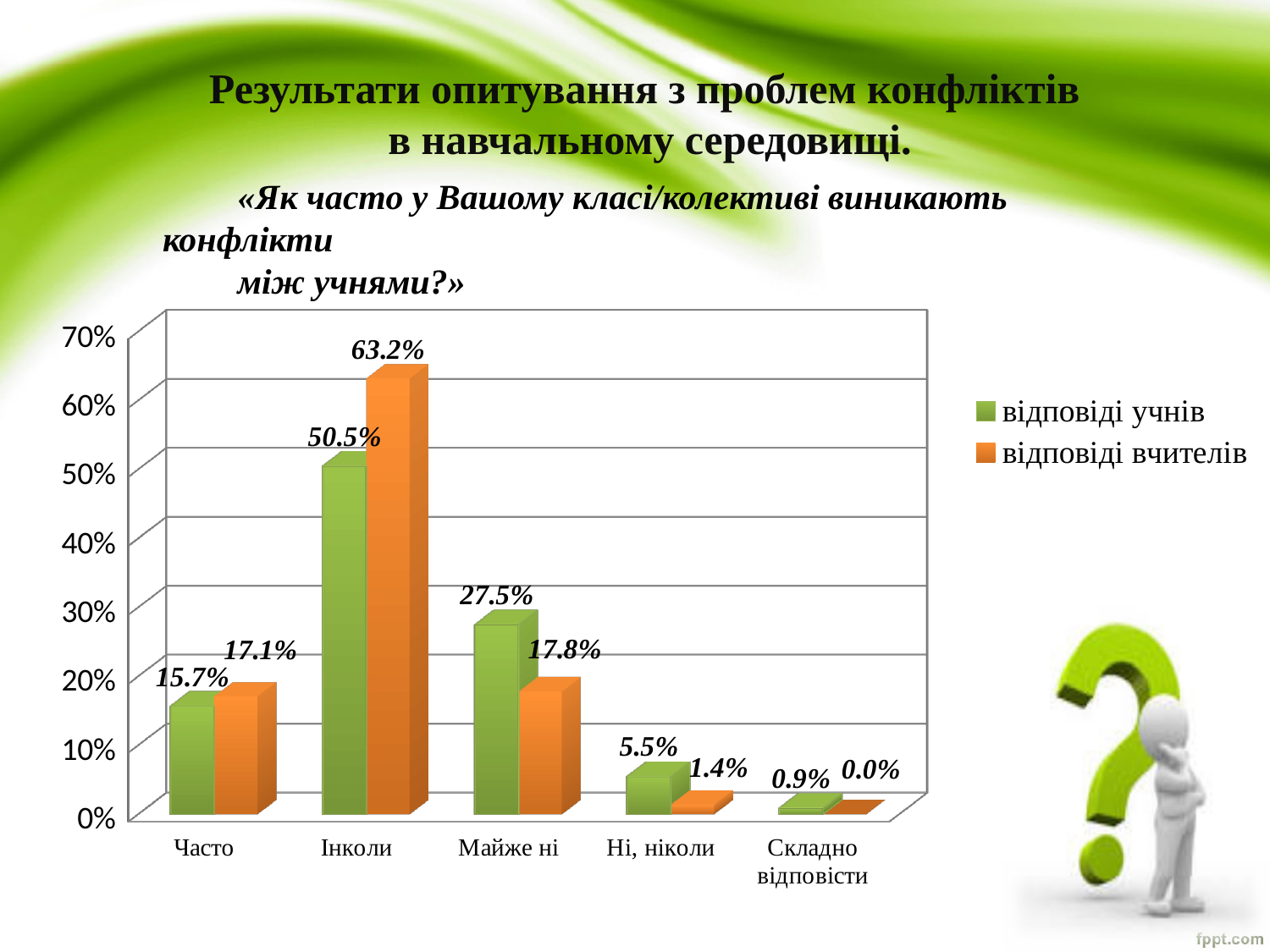
What is the value for "відповіді учнів" in the "Інколи" category? 50.5% Is the value for "відповіді вчителів" in the "Інколи" category greater or less than 60%? greater What is the difference between "відповіді вчителів" and "відповіді учнів" in the "Інколи" category? 12.7% Which colour represents "відповіді вчителів" in the chart? orange Which category has the lowest value for "відповіді учнів"? Складно відповісти What is the value for "відповіді вчителів" in the "Складно відповісти" category? 0.0% How many series does the legend list? 2 How many categories are shown on the x axis? 5 Which category has the highest value for "відповіді вчителів"? Інколи In the "Майже ні" category, which series has the larger value, "відповіді учнів" or "відповіді вчителів"? відповіді учнів What is the value for "відповіді вчителів" in the "Часто" category? 17.1% What kind of chart is shown on the slide? bar chart